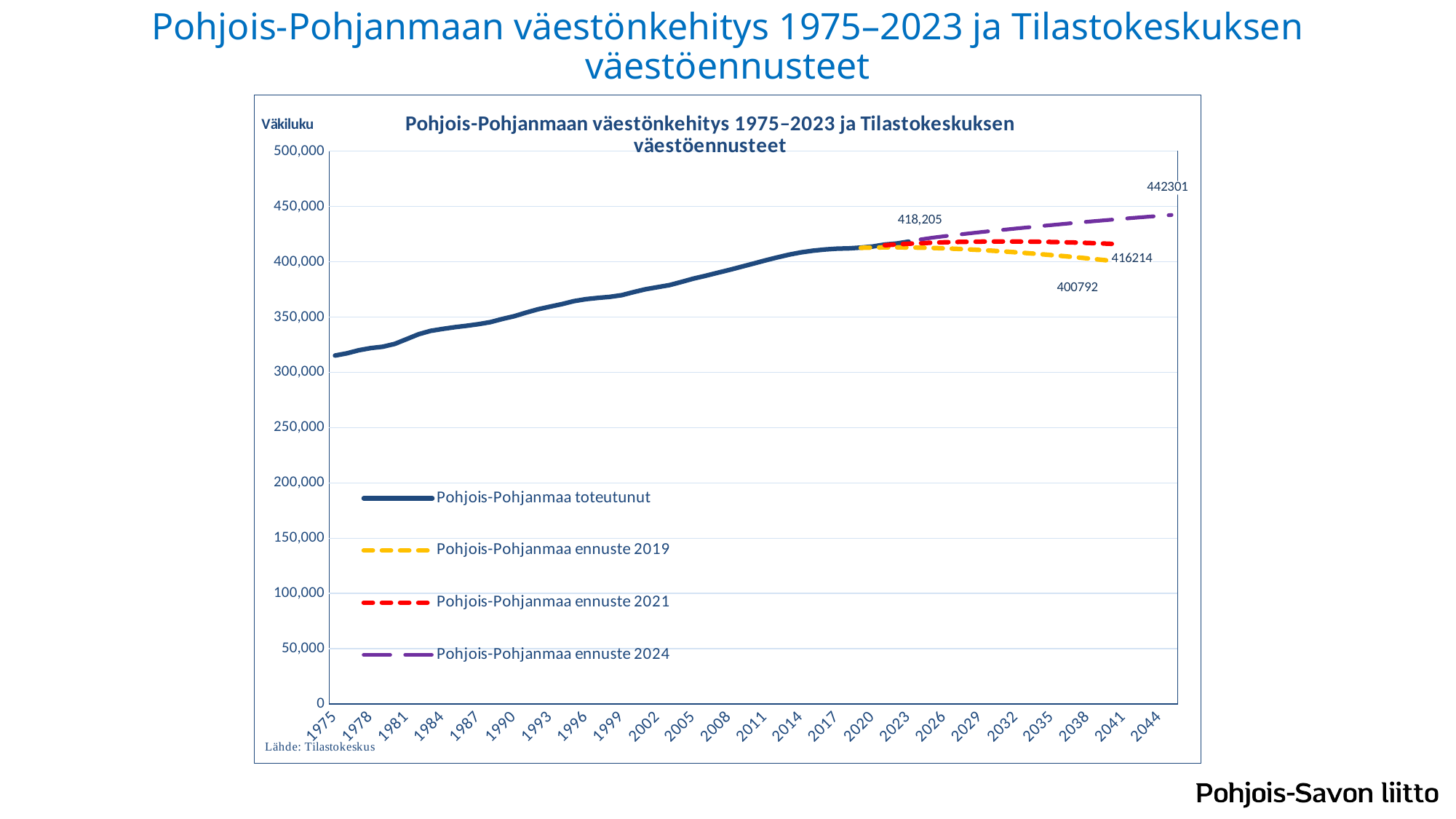
What is the labelled value at the end of the Pohjois-Pohjanmaa toteutunut series? 418,205 How many series does the legend list? 4 What is the labelled end value of the Pohjois-Pohjanmaa ennuste 2024 series? 442301 Which forecast series ends at the highest labelled value? Pohjois-Pohjanmaa ennuste 2024 What is the labelled end value of the Pohjois-Pohjanmaa ennuste 2019 series? 400792 Which forecast series ends at the lowest labelled value? Pohjois-Pohjanmaa ennuste 2019 Does the Pohjois-Pohjanmaa toteutunut series rise or fall from 1975 to 2023? rise Which ends at a larger labelled value, ennuste 2021 or ennuste 2019? ennuste 2021 Is the value of the Pohjois-Pohjanmaa toteutunut series in 1975 greater or less than 350,000? less What is the labelled end value of the Pohjois-Pohjanmaa ennuste 2021 series? 416214 What is the difference between the labelled end values of ennuste 2024 (442301) and ennuste 2019 (400792)? 41509 What kind of chart is shown on the slide? line chart